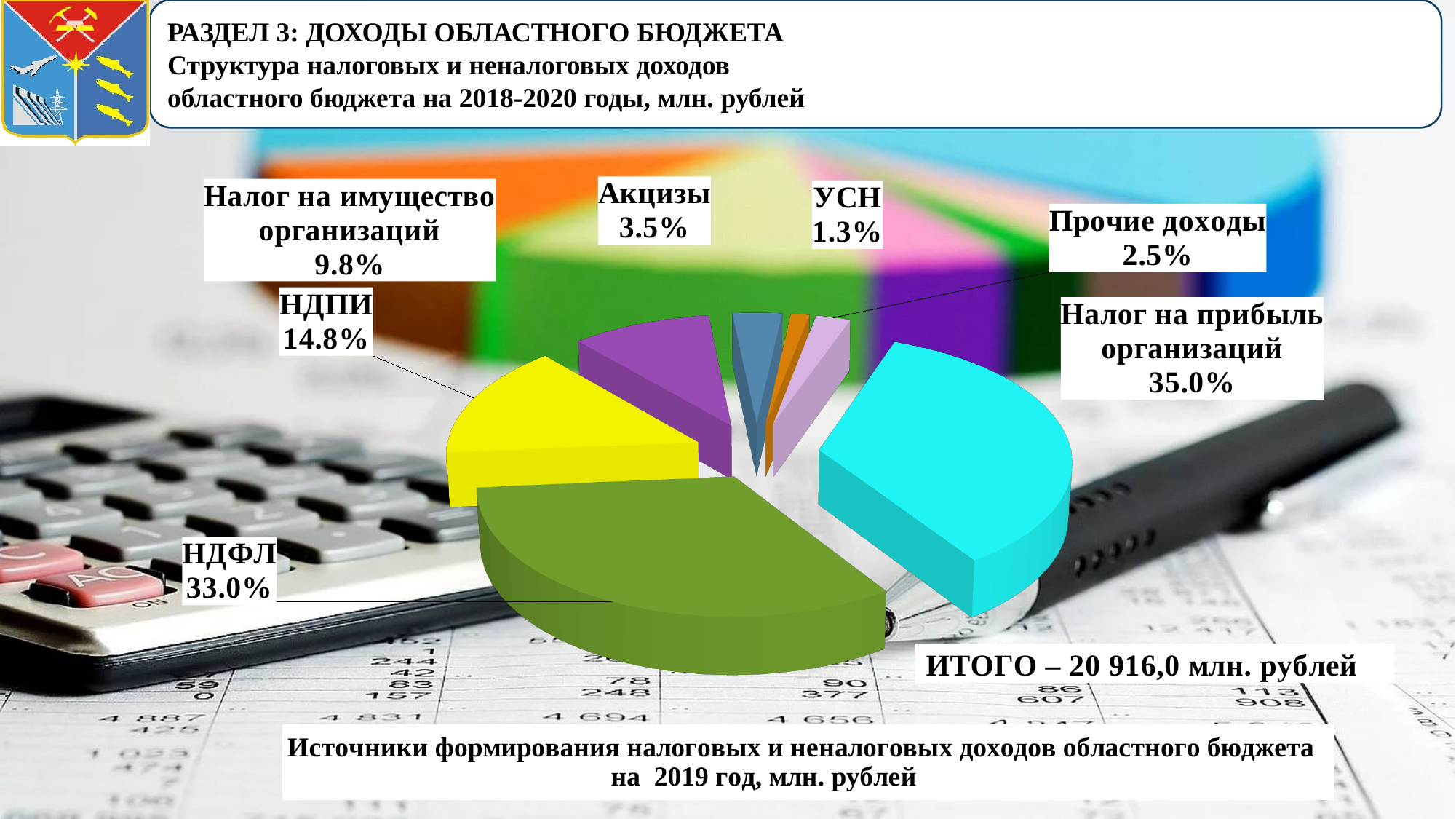
What kind of chart is shown on the slide? Pie chart What share of the pie does "Акцизы" have? 3.5% What share of the pie does "Налог на прибыль организаций" have? 35.0% Which category has the largest share of the pie? Налог на прибыль организаций What share of the pie does "НДПИ" have? 14.8% What share of the pie does "УСН" have? 1.3% What share of the pie does "НДФЛ" have? 33.0% How many categories (slices) does the pie chart have? 7 Which category has the smallest share of the pie? УСН What is the difference in percentage points between "Налог на прибыль организаций" and "НДФЛ"? 2.0 Which is larger: the share for "НДПИ" or the share for "Налог на имущество организаций"? НДПИ What total amount (ИТОГО) is stated on the slide for the pie chart? 20 916,0 млн. рублей